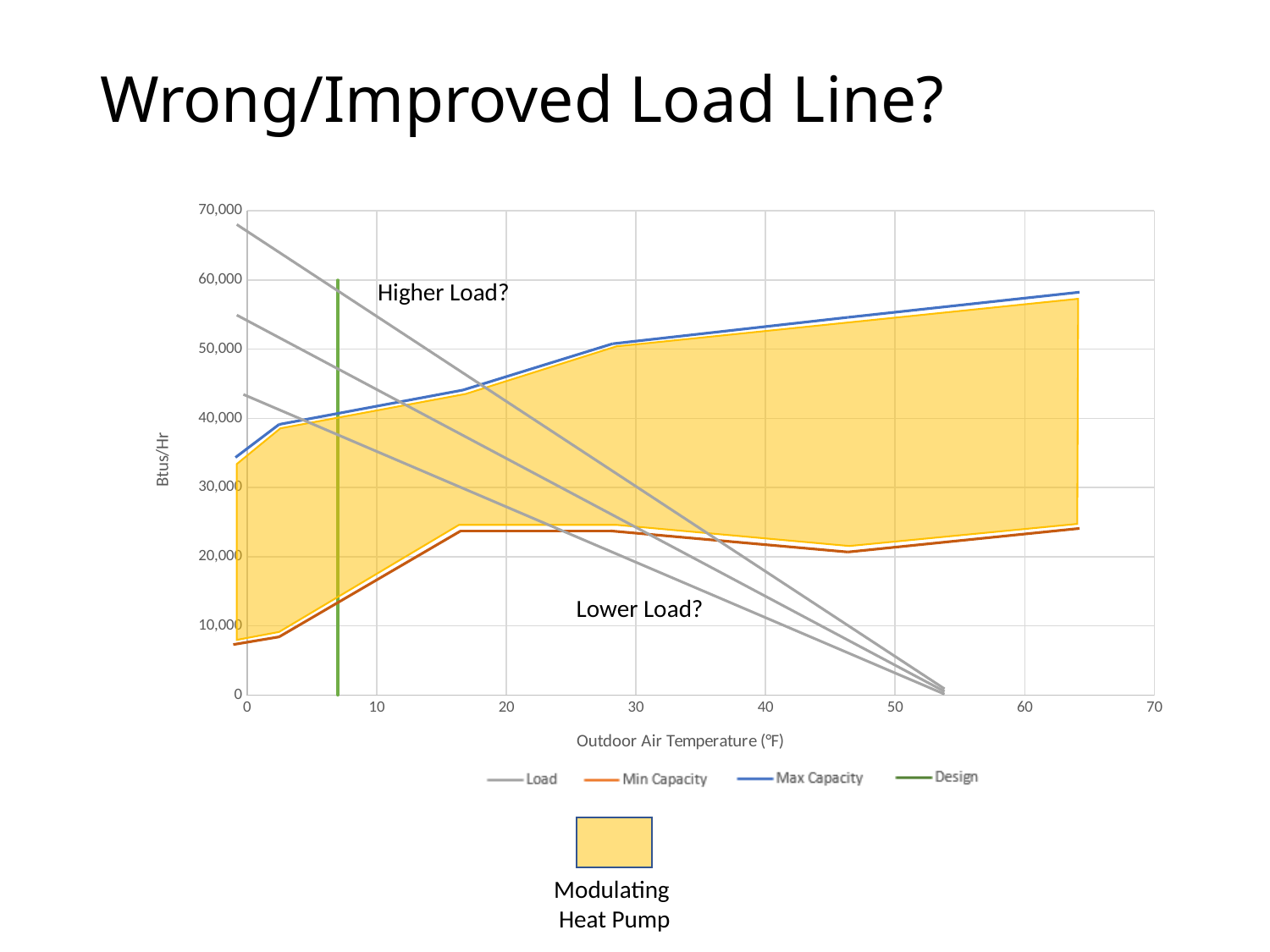
Is the Max Capacity value at 60°F greater or less than 50,000? greater What is the label of the chart's x axis? Outdoor Air Temperature (°F) Is the Min Capacity value at 40°F greater or less than 30,000? less Is the Min Capacity value at 0°F greater or less than 10,000? less How many series does the chart legend list? 4 What is the title of the slide containing the chart? Wrong/Improved Load Line? How many gray Load lines are drawn on the chart? 3 At 30°F, which is larger: Max Capacity or Min Capacity? Max Capacity Does the Max Capacity line rise or fall as outdoor air temperature increases? rise What kind of chart is shown on the slide? line chart Do the gray Load lines rise or fall as outdoor air temperature increases? fall